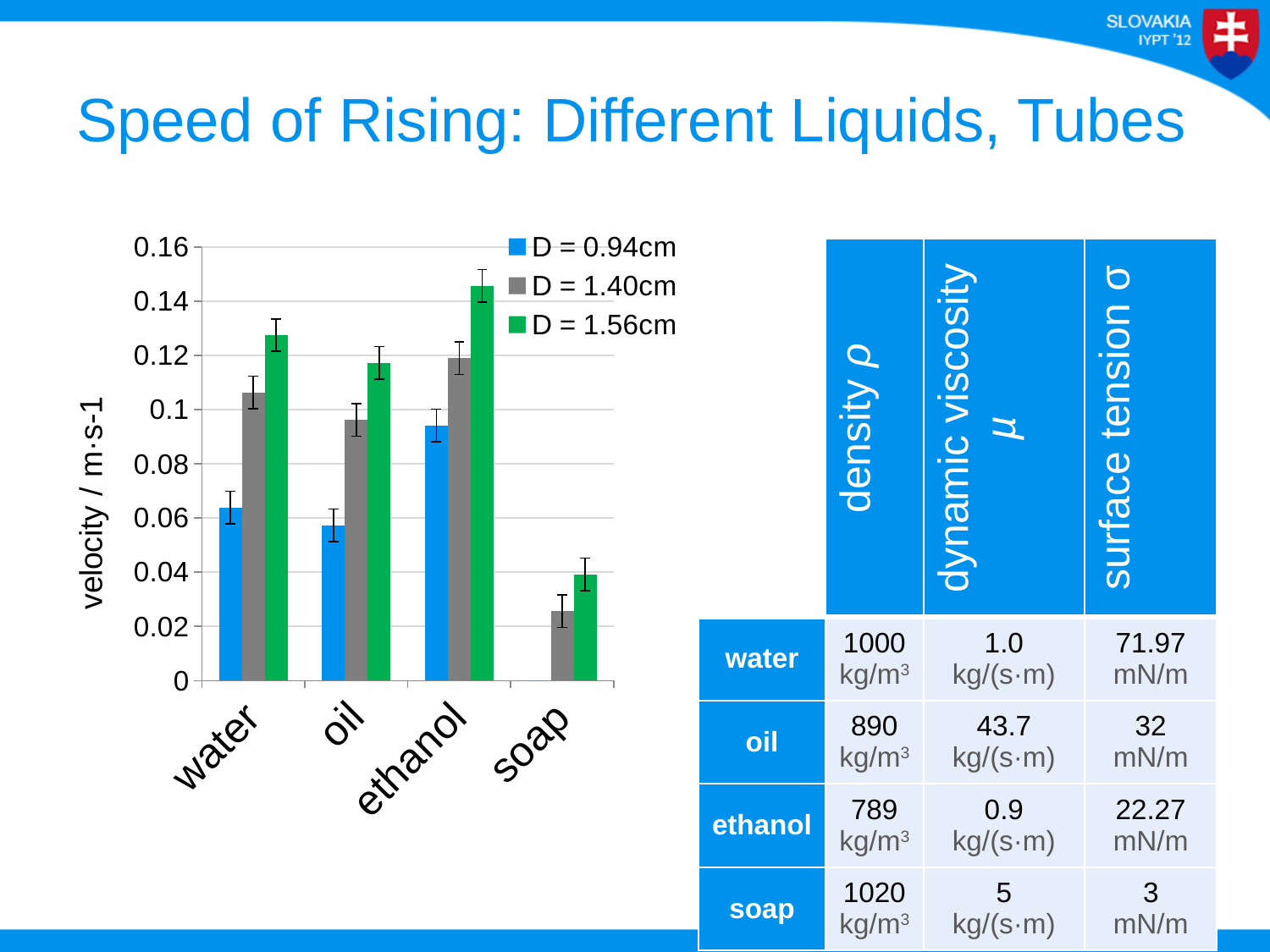
Is the velocity for ethanol at D = 1.56cm greater or less than 0.12? greater How many liquids are shown on the x axis of the chart? 4 Is the velocity for oil at D = 1.40cm greater or less than 0.08? greater Which liquid has the highest velocity for D = 1.40cm? ethanol Which liquid has the lowest velocity for D = 1.56cm? soap What kind of chart is shown on the slide? bar chart For D = 0.94cm, which has the larger velocity, water or ethanol? ethanol What is the label of the chart's y axis? velocity / m·s-1 Is the velocity for water at D = 1.56cm greater or less than 0.1? greater Which liquid has the highest velocity for D = 1.56cm? ethanol How many series does the chart legend list? 3